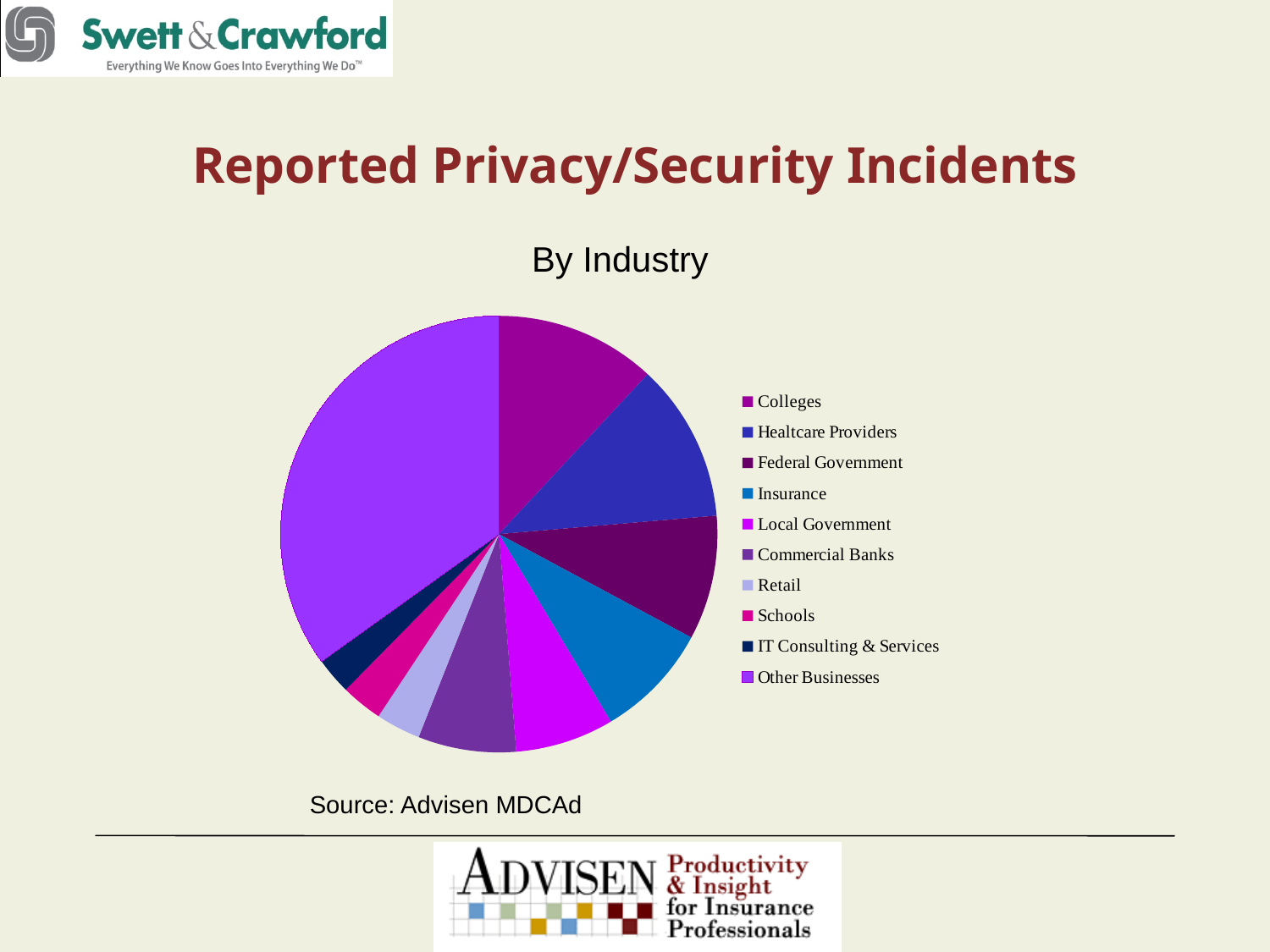
Which slice is larger, Local Government or Retail? Local Government How many industry categories does the pie chart show? 10 What source is cited for the pie chart data? Advisen MDCAd Which slice is larger, Colleges or Schools? Colleges Which slice is larger, Federal Government or IT Consulting & Services? Federal Government What is the subtitle shown above the pie chart? By Industry What kind of chart is shown on the slide? Pie chart Which industry category has the largest slice of the pie chart? Other Businesses